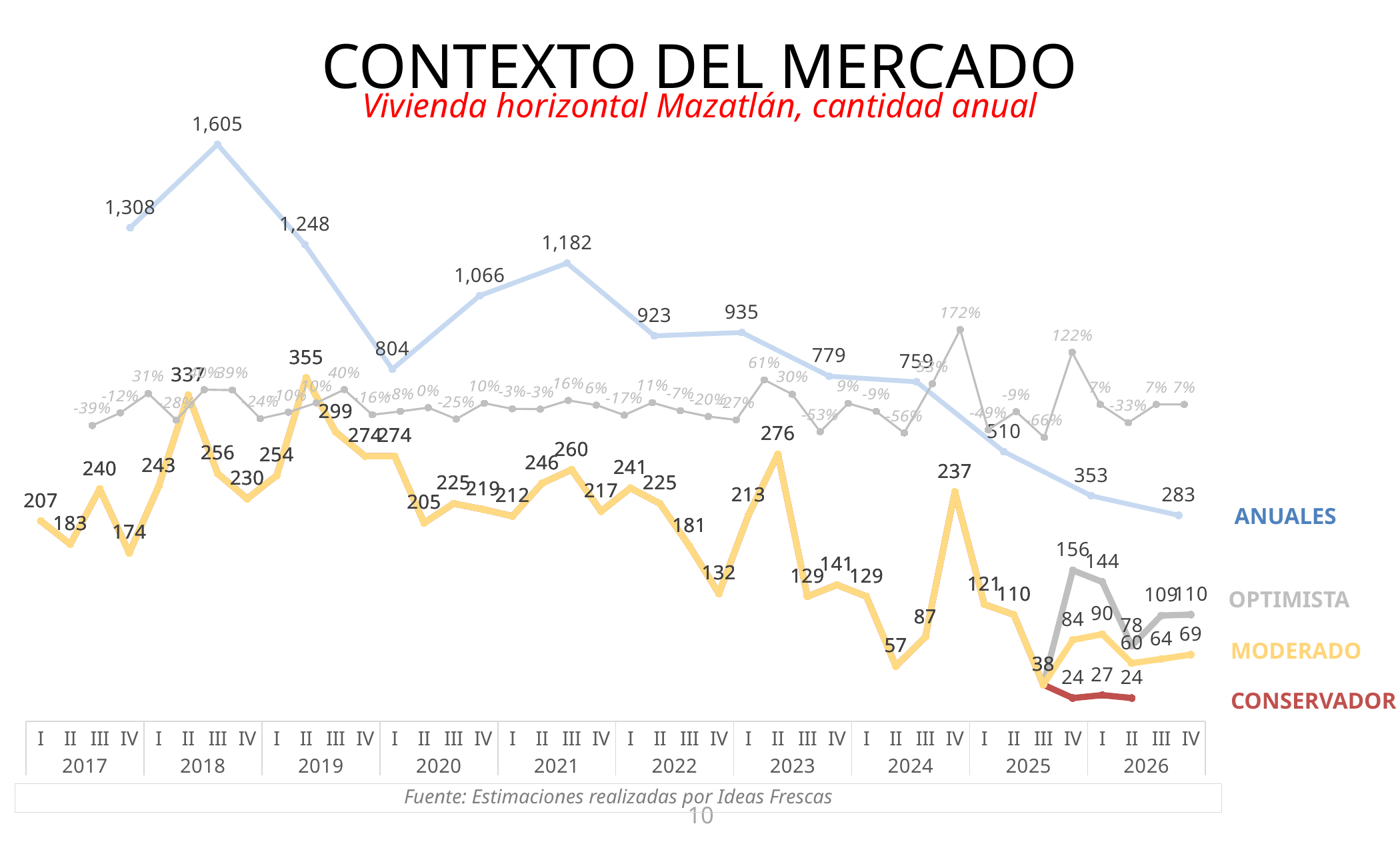
What is the OPTIMISTA value for quarter IV of 2025? 156 What is the lowest value labeled on the ANUALES line? 283 What is the lowest value labeled on the yellow quarterly line? 38 What is the first value labeled on the ANUALES line? 1,308 What is the difference between the OPTIMISTA value (110) and the MODERADO value (69) in quarter IV of 2026? 41 What is the subtitle shown in red under the chart title? Vivienda horizontal Mazatlán, cantidad anual Do the ANUALES values rise or fall from 935 to the end of the line? fall What is the highest value labeled on the CONSERVADOR line? 27 What kind of chart is shown on the slide? line chart Which is larger on the yellow quarterly line: quarter II of 2019 (355) or quarter II of 2018 (337)? quarter II of 2019 How many series does the legend list? 4 What is the highest value labeled on the ANUALES line? 1,605